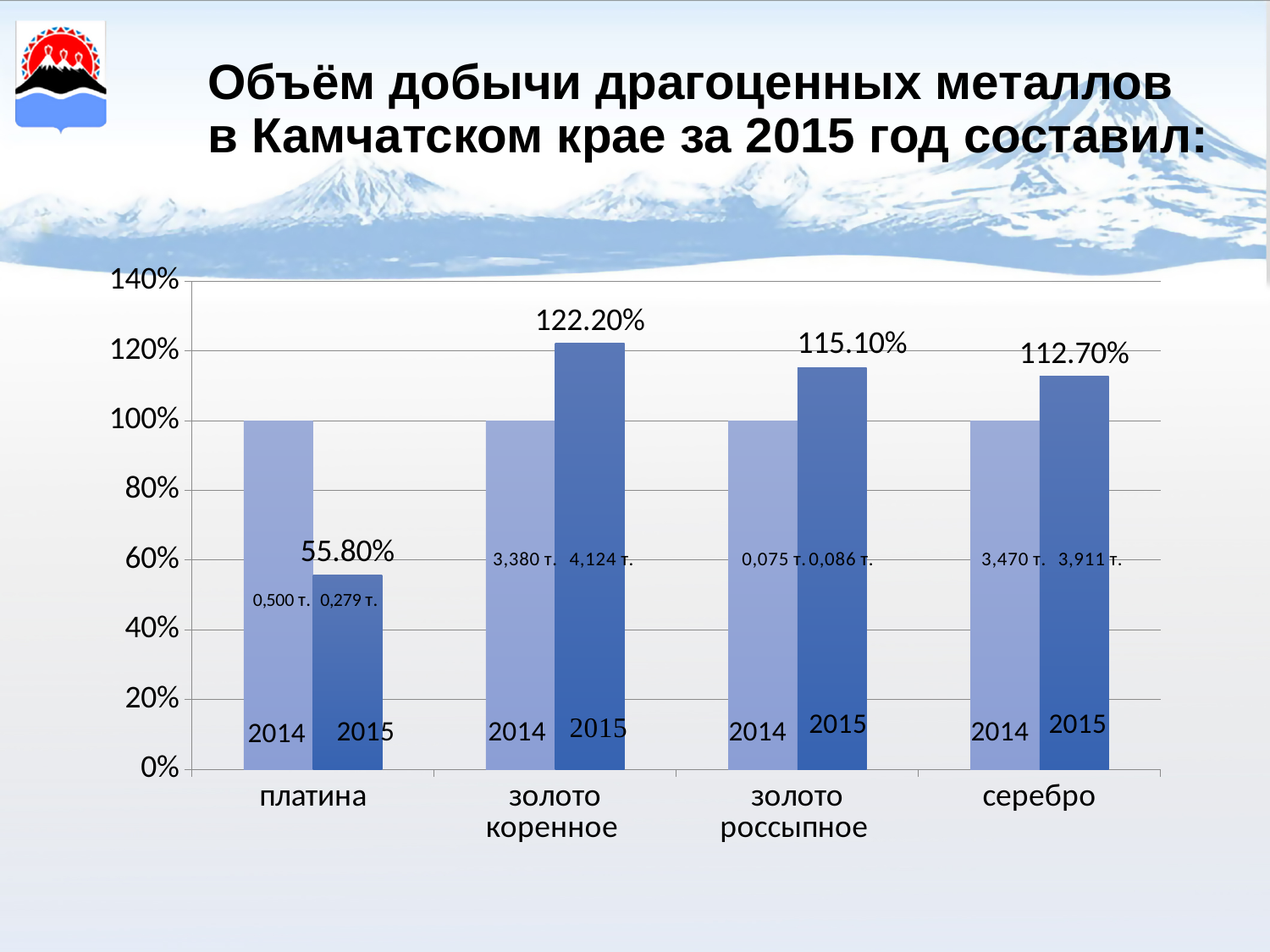
How many categories are shown on the x axis? 4 What kind of chart is shown on the slide? bar chart Which is larger, the 2015 percentage for золото россыпное or for серебро? золото россыпное What is the 2015 value shown for золото коренное? 122.20% What is the 2015 value shown for платина? 55.80% Which category has the lowest 2015 percentage? платина What tonnage is labelled on the 2014 bar for золото коренное? 3,380 т. What tonnage is labelled on the 2015 bar for серебро? 3,911 т. What is the 2015 value shown for золото россыпное? 115.10% What is the difference between the 2015 percentages for золото коренное and серебро? 9.50% What is the 2015 value shown for серебро? 112.70% Which category has the highest 2015 percentage? золото коренное